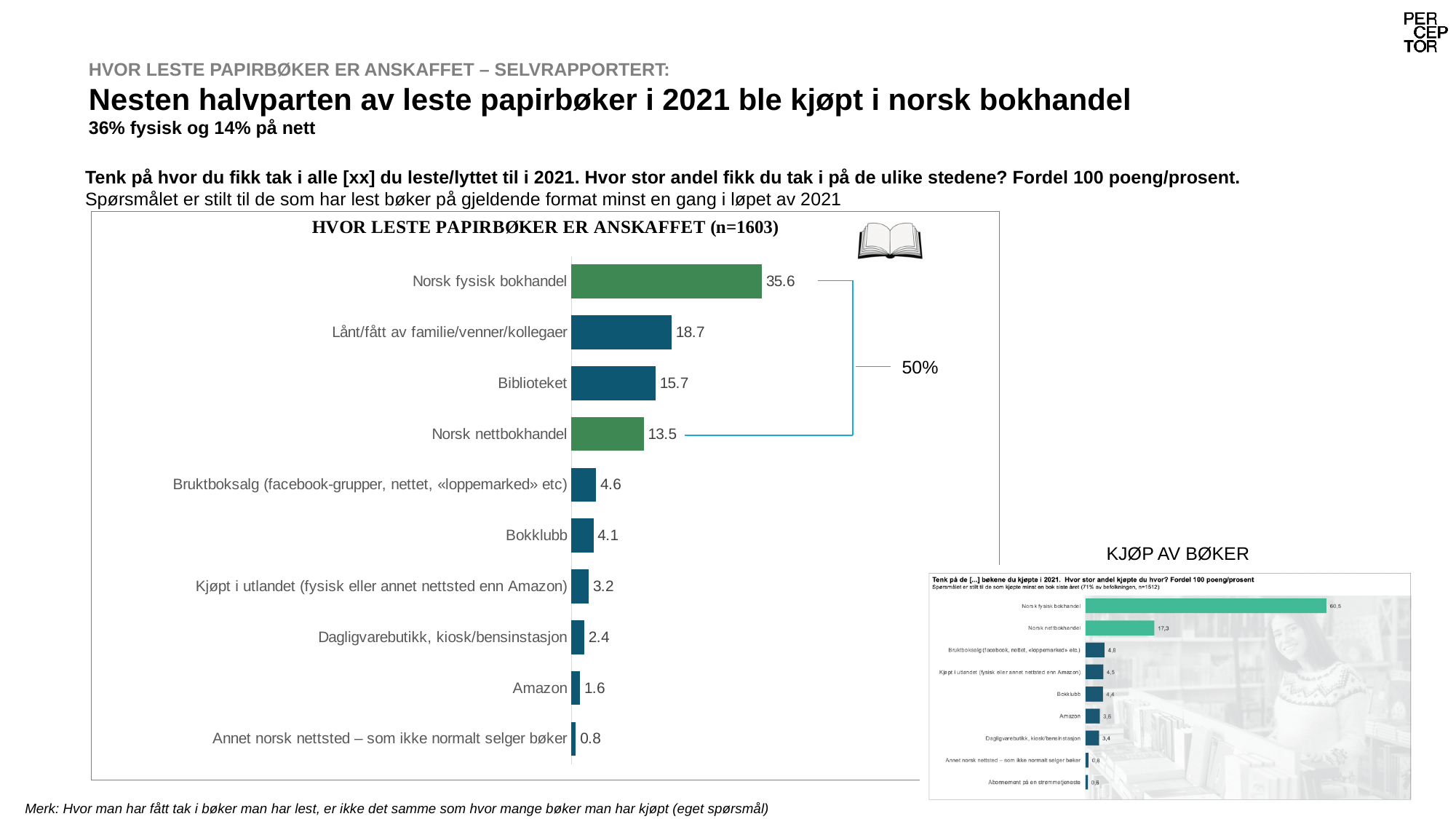
In the chart 'HVOR LESTE PAPIRBØKER ER ANSKAFFET (n=1603)', what is the value for Biblioteket? 15.7 In the chart 'HVOR LESTE PAPIRBØKER ER ANSKAFFET (n=1603)', what is the value for Norsk nettbokhandel? 13.5 In the chart 'HVOR LESTE PAPIRBØKER ER ANSKAFFET (n=1603)', what is the value for Amazon? 1.6 In the chart 'HVOR LESTE PAPIRBØKER ER ANSKAFFET (n=1603)', which category has the highest value? Norsk fysisk bokhandel What kind of chart is 'HVOR LESTE PAPIRBØKER ER ANSKAFFET (n=1603)'? Bar chart In the chart 'HVOR LESTE PAPIRBØKER ER ANSKAFFET (n=1603)', how many categories are shown? 10 In the chart 'HVOR LESTE PAPIRBØKER ER ANSKAFFET (n=1603)', what percentage label is shown next to the bracket joining Norsk fysisk bokhandel and Norsk nettbokhandel? 50% In the chart 'HVOR LESTE PAPIRBØKER ER ANSKAFFET (n=1603)', which is larger: Lånt/fått av familie/venner/kollegaer or Biblioteket? Lånt/fått av familie/venner/kollegaer In the chart 'HVOR LESTE PAPIRBØKER ER ANSKAFFET (n=1603)', what is the combined total of Norsk fysisk bokhandel and Norsk nettbokhandel? 49.1 In the chart 'HVOR LESTE PAPIRBØKER ER ANSKAFFET (n=1603)', what is the value for Norsk fysisk bokhandel? 35.6 In the chart 'HVOR LESTE PAPIRBØKER ER ANSKAFFET (n=1603)', what is the difference between Norsk fysisk bokhandel and Norsk nettbokhandel? 22.1 In the chart 'HVOR LESTE PAPIRBØKER ER ANSKAFFET (n=1603)', which category has the lowest value? Annet norsk nettsted – som ikke normalt selger bøker